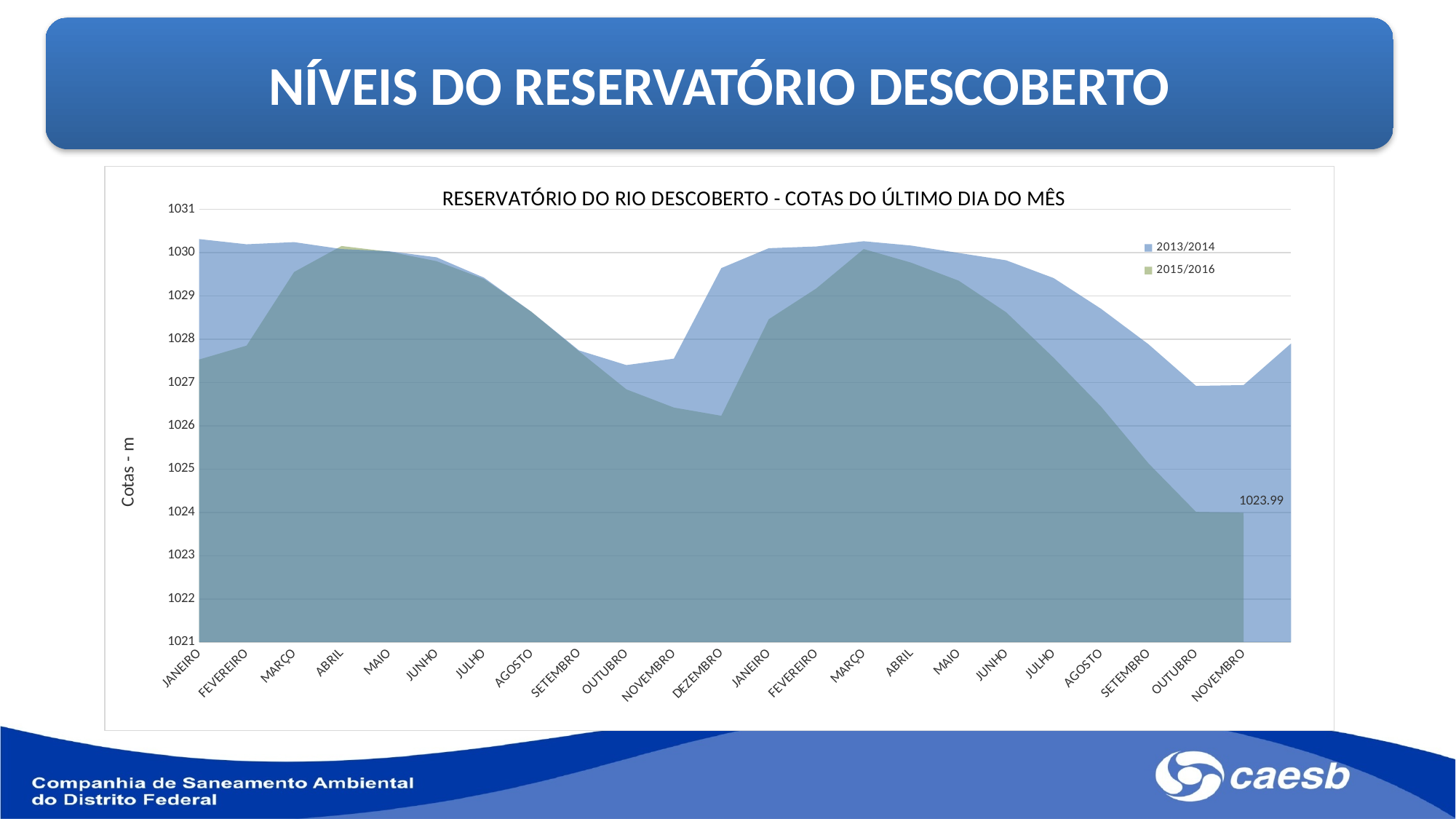
In Dezembro, which series has the larger value, 2013/2014 or 2015/2016? 2013/2014 Is the value for 2013/2014 in the first Janeiro greater or less than 1030? greater Which month has the lowest value for the 2015/2016 series? Novembro (second year) Does the 2013/2014 series rise or fall from Dezembro to the second Abril? rise Is the value for 2015/2016 in Dezembro greater or less than 1027? less How many months are plotted along the x axis? 23 What kind of chart is shown on the slide? area chart What is the value labelled for the 2015/2016 series at the final Novembro? 1023.99 What is the label on the y axis? Cotas - m Does the 2015/2016 series rise or fall from the second Março to the second Outubro? fall Is the value for 2013/2014 in the second Outubro greater or less than 1028? less How many series does the legend list? 2